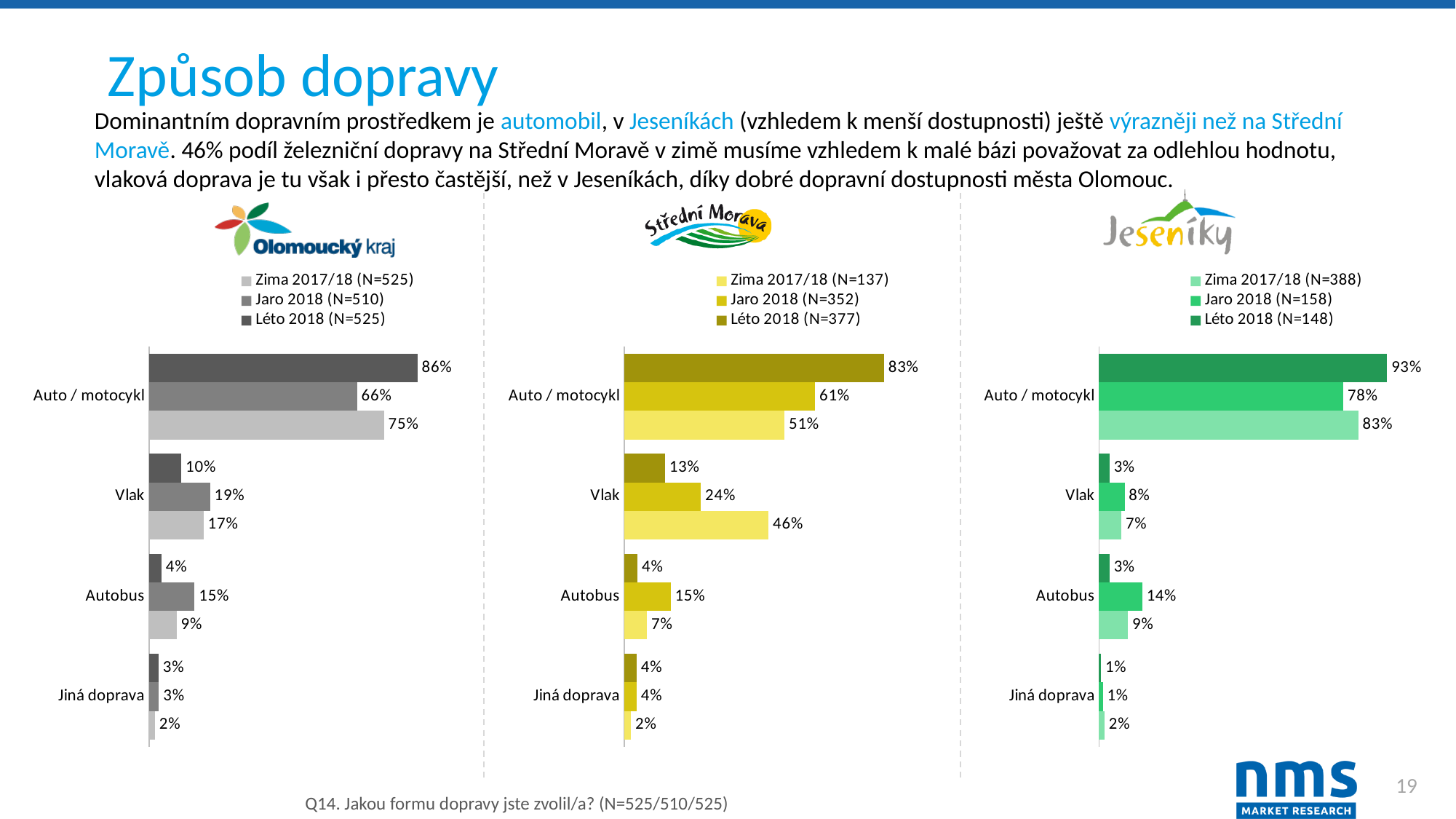
How many categories are shown in the Olomoucký kraj chart (left)? 4 How many series does the legend of the Střední Morava chart (middle) list? 3 In the Olomoucký kraj chart (left), what is the value for Auto / motocykl in Léto 2018? 86% In the Olomoucký kraj chart (left), what is the difference between the Jaro 2018 and Léto 2018 values for Autobus? 11% In the Olomoucký kraj chart (left), which category has the lowest value in Zima 2017/18? Jiná doprava What is the sample size (N) for Zima 2017/18 in the Jeseníky chart (right) legend? N=388 In the Střední Morava chart (middle), what is the value for Vlak in Zima 2017/18? 46% In the Jeseníky chart (right), what is the value for Autobus in Jaro 2018? 14% What kind of chart is the Jeseníky chart (right)? Bar chart In the Jeseníky chart (right), which is larger for Vlak: the Jaro 2018 value or the Zima 2017/18 value? Jaro 2018 In the Jeseníky chart (right), which category has the highest value in Léto 2018? Auto / motocykl In the Střední Morava chart (middle), what is the difference between the Léto 2018 and Zima 2017/18 values for Auto / motocykl? 32%